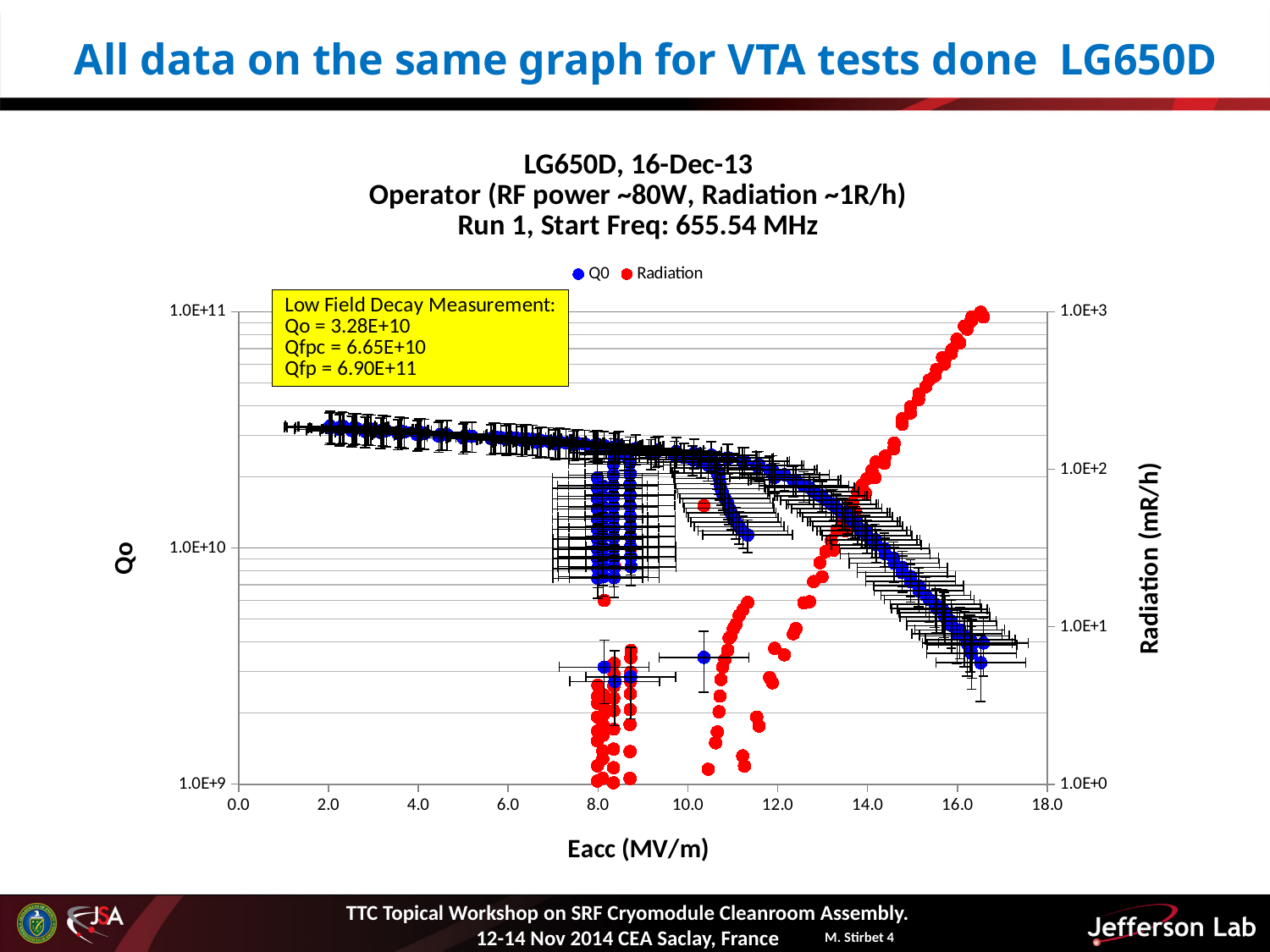
What kind of chart is shown on the slide? scatter chart Is the Radiation value at Eacc of about 16.0 MV/m greater or less than 1.0E+2 mR/h? greater Is the Q0 value at Eacc of about 16.5 MV/m greater or less than 1.0E+10? less Is the Q0 value at Eacc of about 2.0 MV/m greater or less than 1.0E+10? greater What is the Qo value given in the Low Field Decay Measurement box on the chart? 3.28E+10 Does the Q0 series rise or fall as Eacc increases along the x axis? fall How many series does the chart legend list? 2 Does the Radiation series rise or fall as Eacc increases along the x axis? rise What is the label of the x axis of the chart? Eacc (MV/m) What are the two series named in the chart legend? Q0 and Radiation What is the highest tick value shown on the x axis of the chart? 18.0